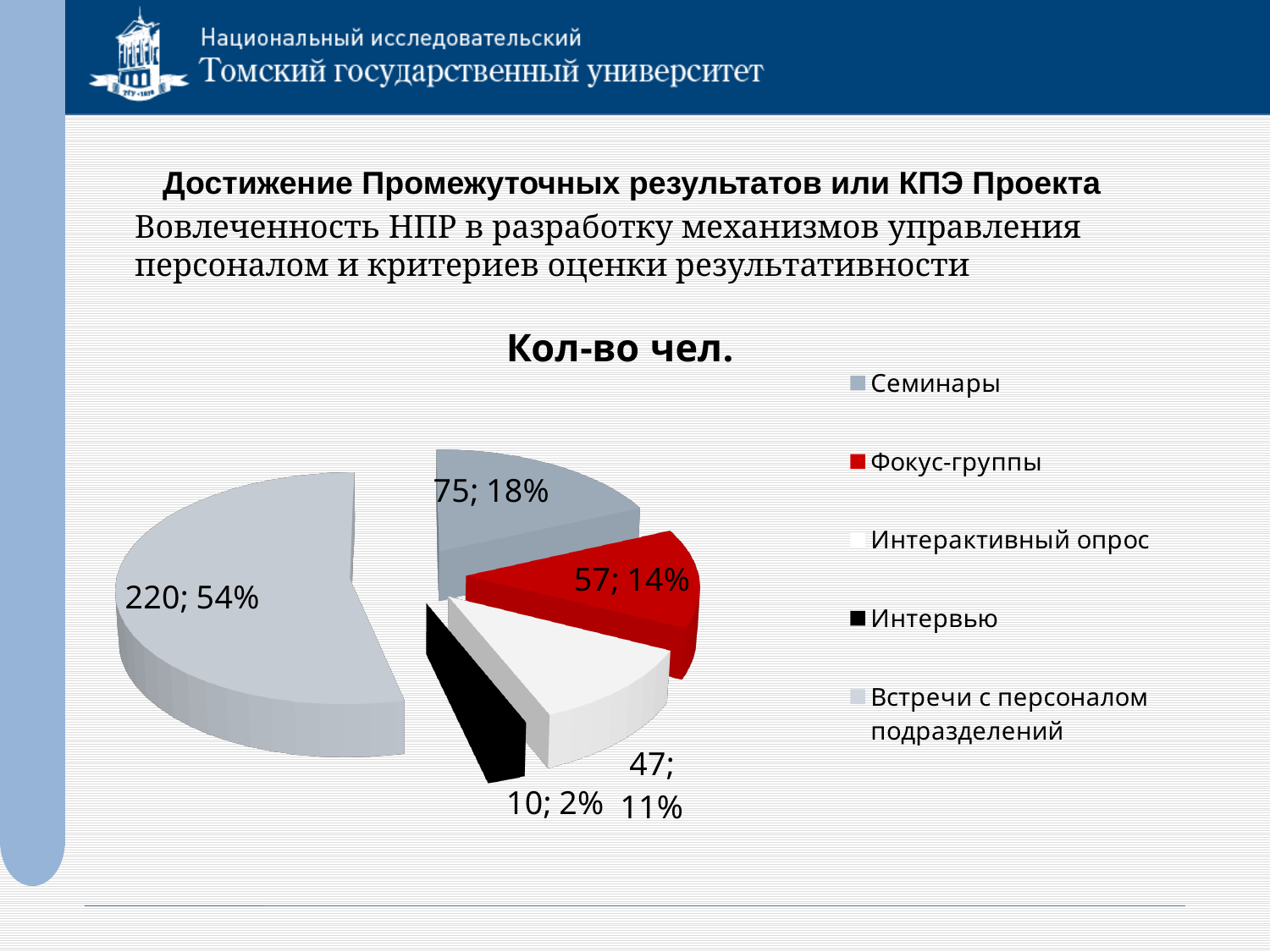
What kind of chart is shown on the slide? Pie chart What is the difference between the values for Семинары and Фокус-группы? 18 Which category has the smallest slice of the pie? Интервью What is the value for Интервью? 10 Which category has the largest slice of the pie? Встречи с персоналом подразделений What is the value for Встречи с персоналом подразделений? 220 What share of the pie does Интерактивный опрос take? 11% What is the title of the chart? Кол-во чел. What share of the pie does Встречи с персоналом подразделений take? 54% What is the value for Фокус-группы? 57 How many categories does the legend of the pie chart list? 5 What is the value for Семинары? 75